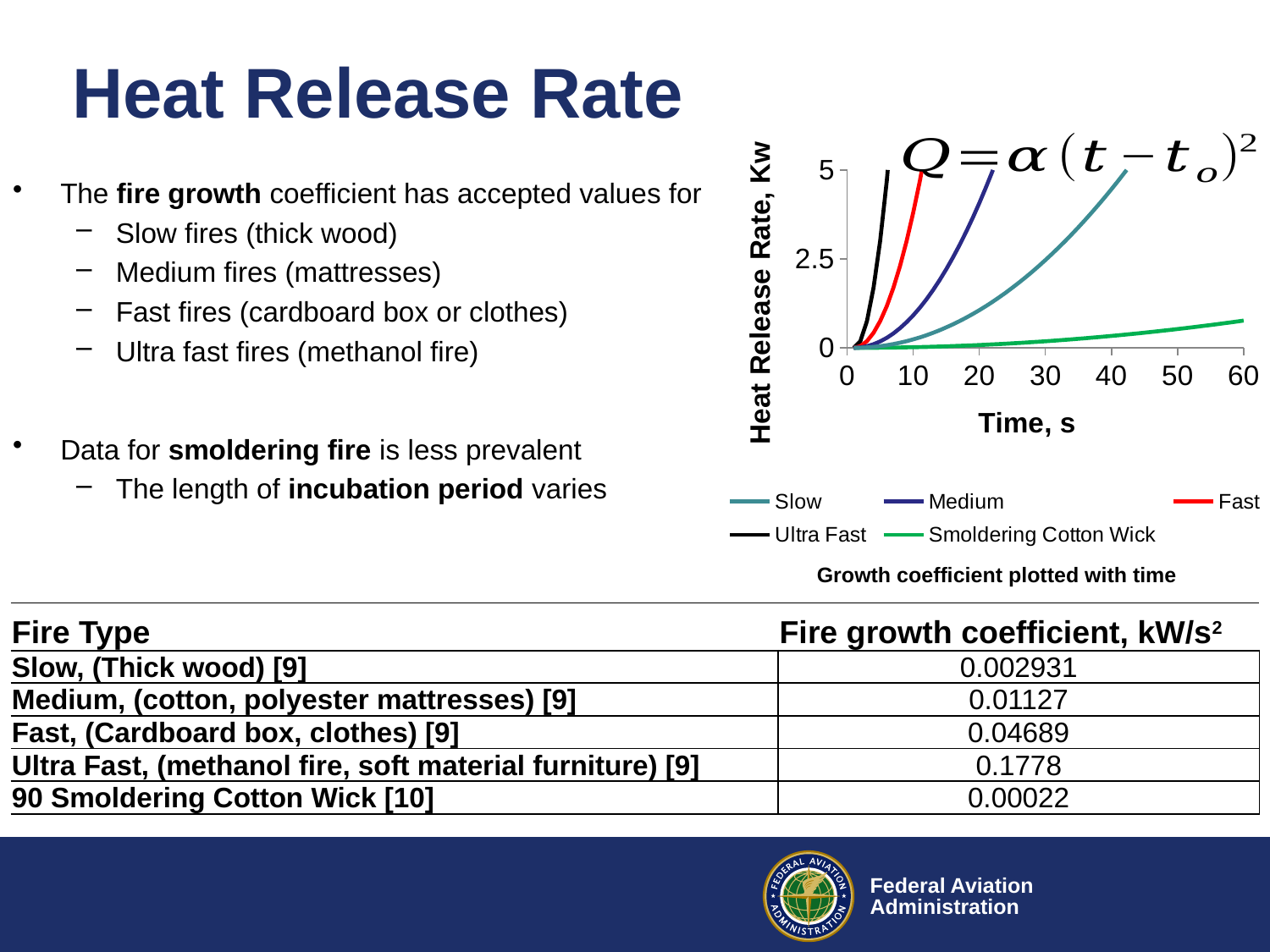
Is the heat release rate for Slow at 40 s greater or less than 2.5? greater How many series does the chart's legend list? 5 Which series has the lowest heat release rate at 60 s? Smoldering Cotton Wick What kind of chart is shown on the slide? line chart Is the heat release rate for Slow at 20 s greater or less than 2.5? less Do the heat release rate curves rise or fall as time increases? rise What colour is the Fast series in the chart's legend? red What is the title of the chart's x axis? Time, s Which series reaches a heat release rate of 5 kW at the earliest time? Ultra Fast Is the heat release rate for Smoldering Cotton Wick at 60 s greater or less than 2.5? less At 30 s, which series has the higher heat release rate, Slow or Smoldering Cotton Wick? Slow